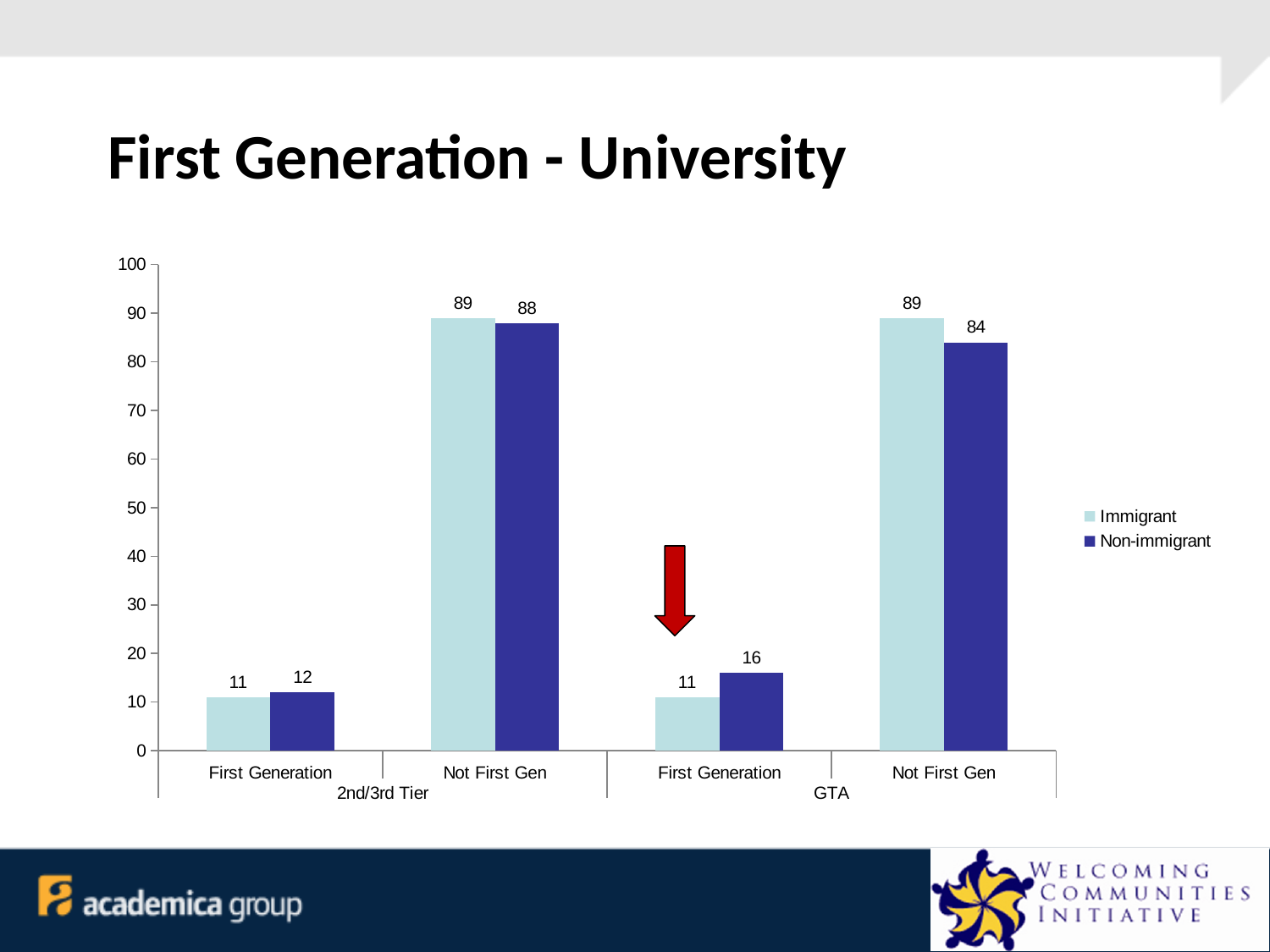
What kind of chart is shown on the slide? Bar chart What is the title of the slide? First Generation - University What is the Immigrant value for First Generation in the 2nd/3rd Tier group? 11 What is the Non-immigrant value for Not First Gen in the GTA group? 84 What is the difference between the Non-immigrant and Immigrant values for First Generation in the GTA group? 5 What is the Immigrant value for Not First Gen in the 2nd/3rd Tier group? 89 Which category has the lowest Non-immigrant value? First Generation (2nd/3rd Tier) For Not First Gen in the 2nd/3rd Tier group, which is larger: the Immigrant value or the Non-immigrant value? Immigrant How many series does the legend list? 2 What is the difference between the Immigrant and Non-immigrant values for Not First Gen in the GTA group? 5 How many categories are shown along the x axis? 4 What is the Non-immigrant value for First Generation in the GTA group? 16